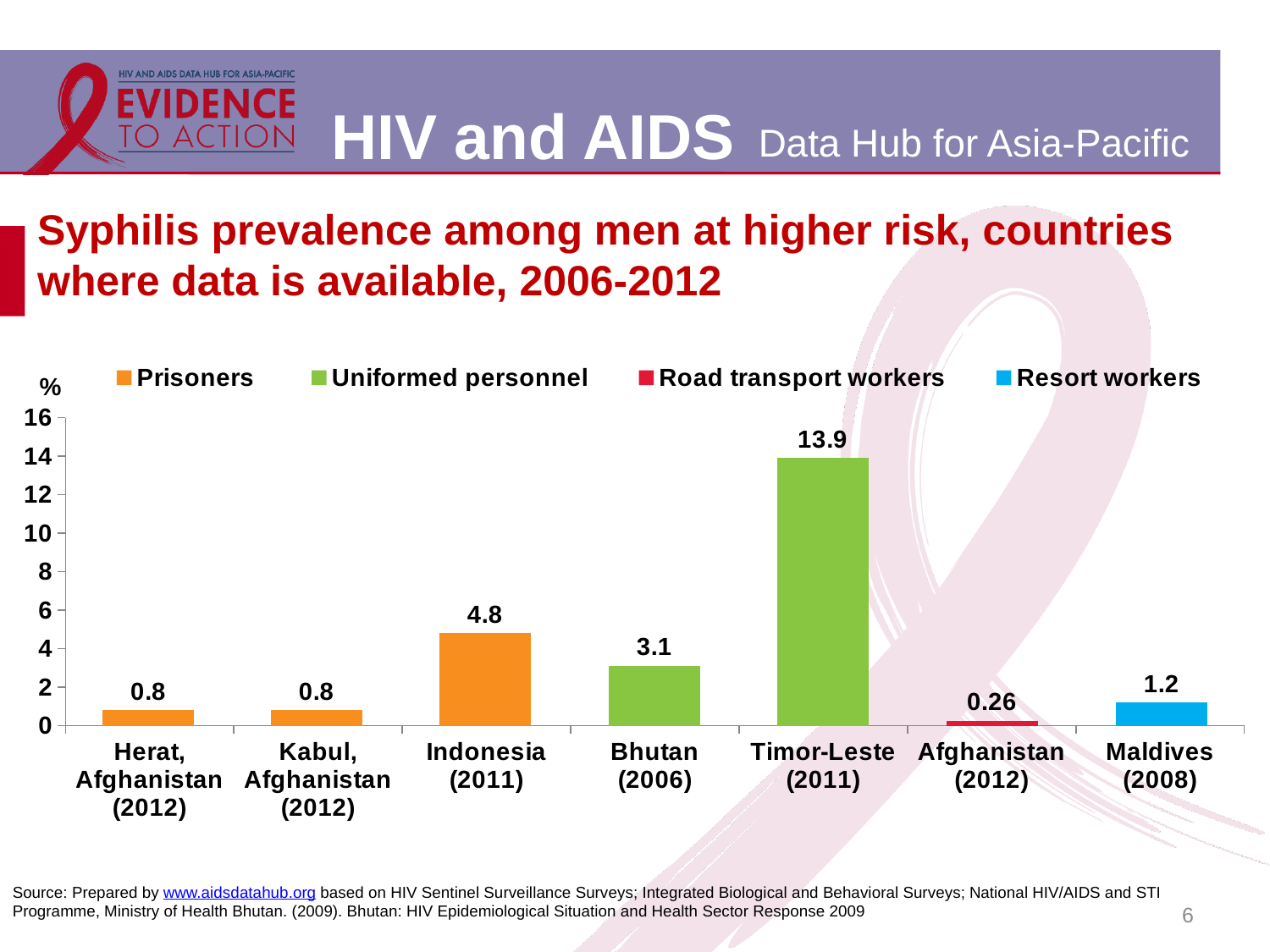
How many series does the legend list? 4 What is the value shown for Indonesia (2011)? 4.8 Which is larger, the value for Indonesia (2011) or the value for Maldives (2008)? Indonesia (2011) Which series does the legend show in green? Uniformed personnel What is the difference between the values for Timor-Leste (2011) and Bhutan (2006)? 10.8 Is the value for Timor-Leste (2011) greater or less than 12? greater How many categories are shown on the x axis? 7 What is the value shown for Afghanistan (2012) among road transport workers? 0.26 What is the syphilis prevalence value for Timor-Leste (2011)? 13.9 What kind of chart is shown on the slide? Bar chart Which category has the highest syphilis prevalence? Timor-Leste (2011) Which category has the lowest syphilis prevalence? Afghanistan (2012)